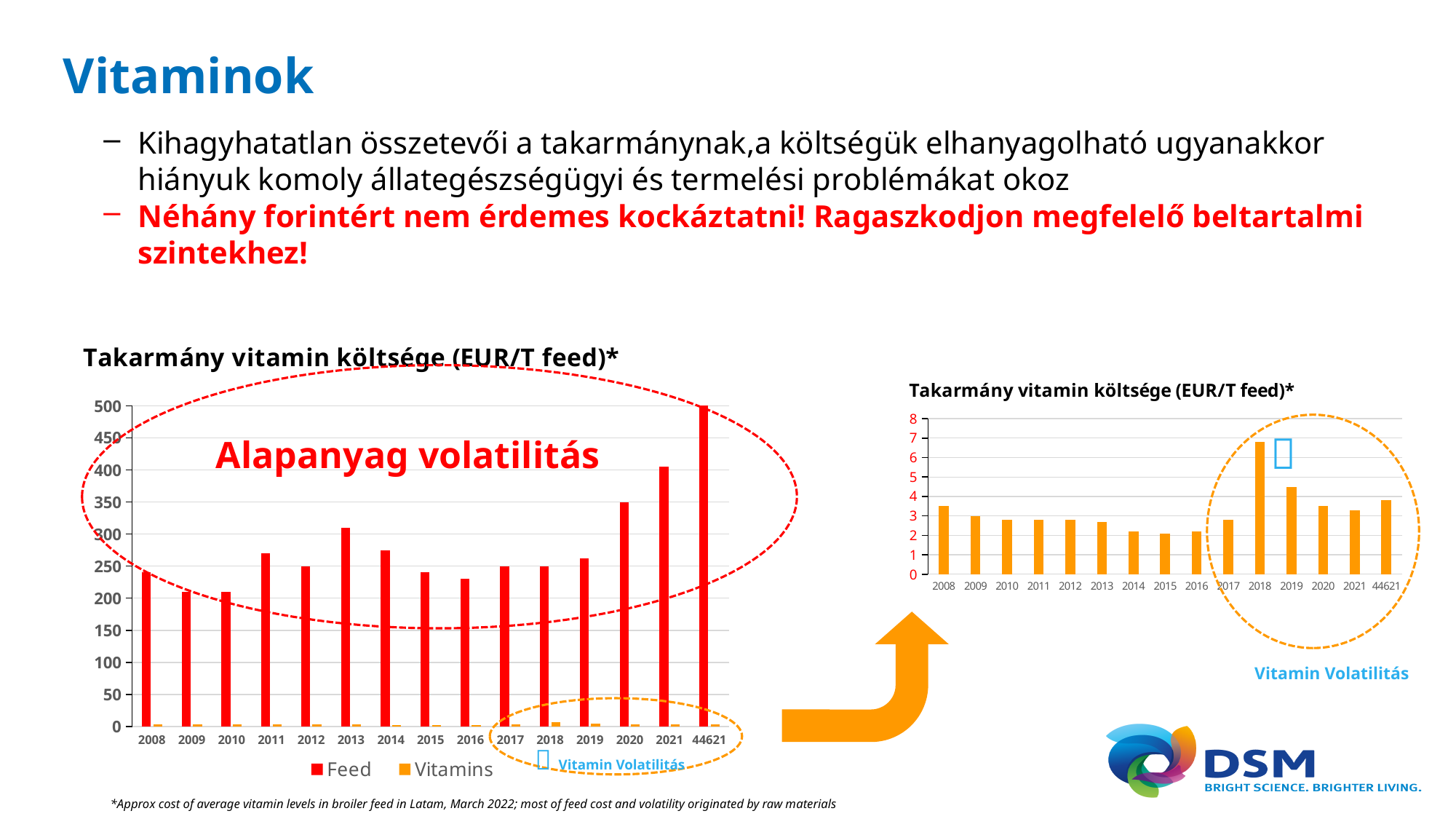
In the right chart, is the value for 2018 greater or less than 6? greater In the left chart, which category has the highest Feed value? 44621 What are the two legend entries of the left chart? Feed and Vitamins In the right chart, which has the larger value, 2019 or 2020? 2019 What kind of chart is the left chart titled 'Takarmány vitamin költsége (EUR/T feed)*'? Bar chart In the left chart, is the Feed value for 2020 greater or less than 300? greater How many categories are shown on the x axis of the left chart? 15 How many series does the legend of the left chart list? 2 In the left chart, which has the larger Feed value, 2013 or 2014? 2013 In the right chart, which category has the highest value? 2018 In the left chart, is the Feed value for 2009 greater or less than 250? less